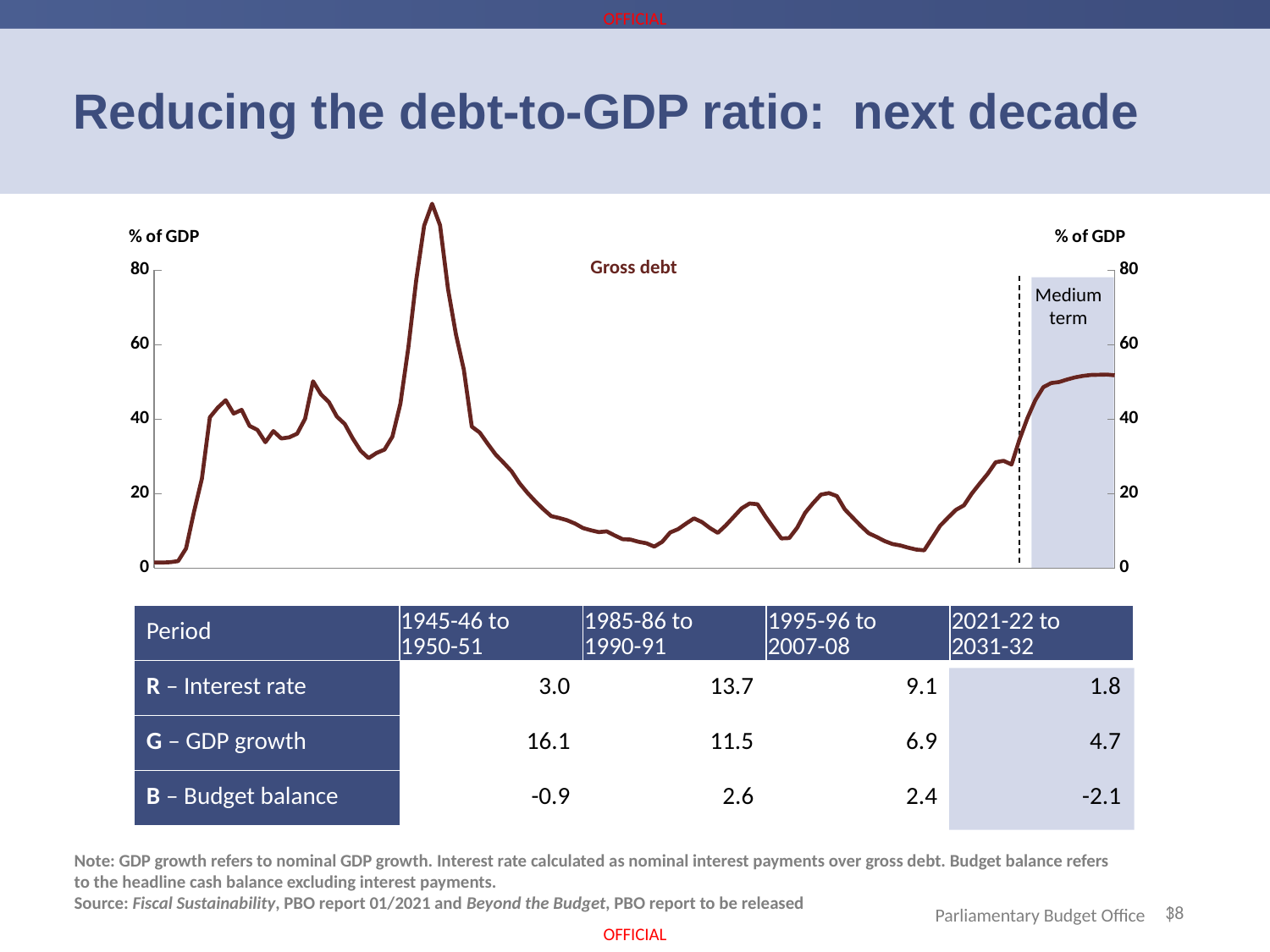
Is the highest point of the Gross debt line greater or less than 60? greater Is the value of Gross debt at the far left start of the line greater or less than 20? less How many data series does the chart plot? 1 Is the value of Gross debt at the end of the Medium term shaded region greater or less than 40? greater What type of chart is shown on the slide? line chart What is the name of the series plotted on the chart? Gross debt Within the Medium term shaded region, does the Gross debt line rise or fall? rise What label is given to the shaded region at the right of the chart? Medium term